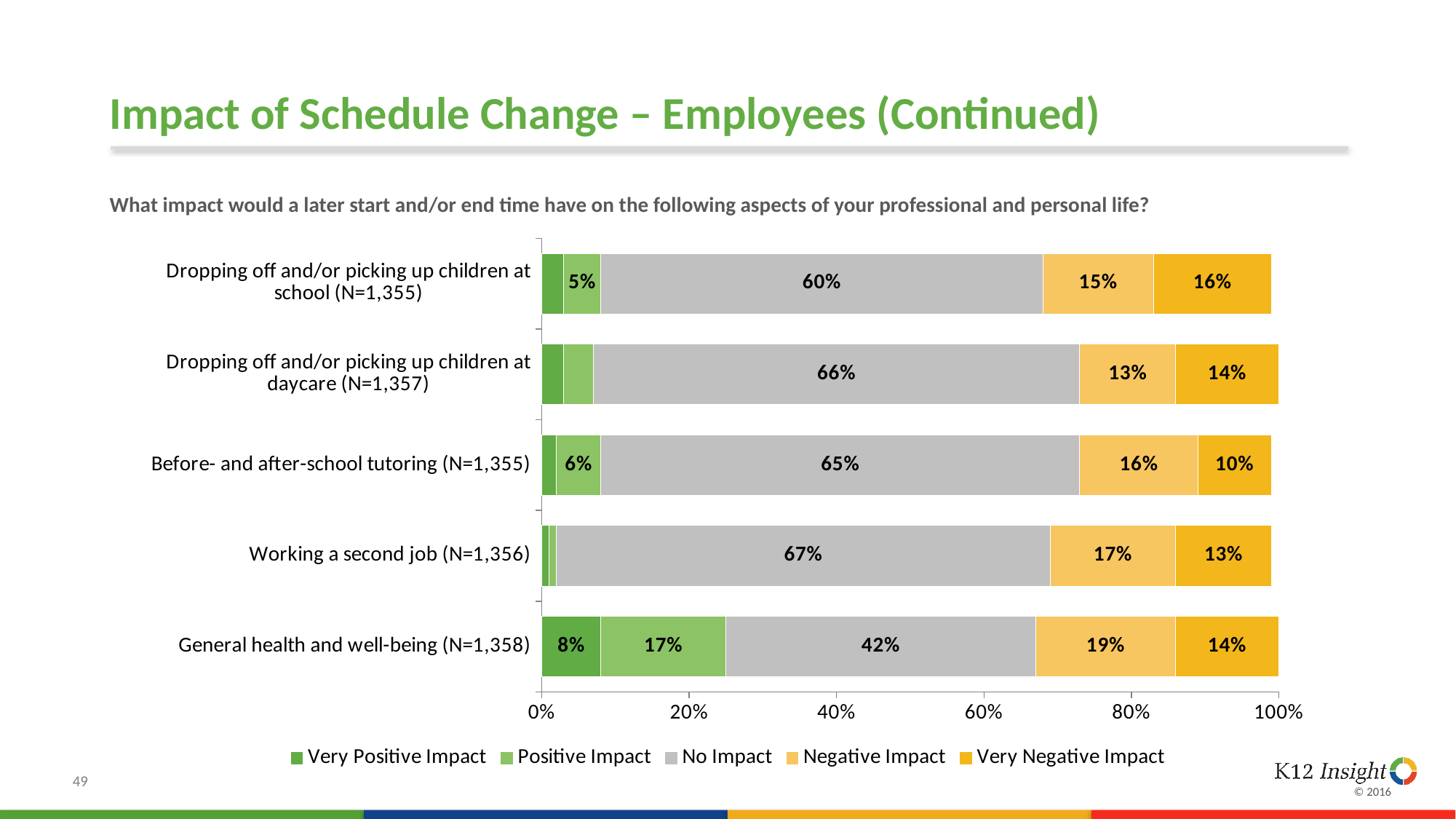
What is the total of all segments in the General health and well-being (N=1,358) bar? 100% How many series does the legend list? 5 How many categories (aspects of life) are plotted in the chart? 5 Which has the larger Negative Impact value: Working a second job (N=1,356) or Dropping off and/or picking up children at daycare (N=1,357)? Working a second job (N=1,356) What is the Very Positive Impact value for General health and well-being (N=1,358)? 8% Which category has the highest No Impact value? Working a second job (N=1,356) Which legend entry is shown in grey? No Impact What is the Very Negative Impact value for Before- and after-school tutoring (N=1,355)? 10% What is the No Impact value for Working a second job (N=1,356)? 67% What kind of chart is shown on the slide? Stacked bar chart What is the difference between the No Impact value for Dropping off and/or picking up children at school (N=1,355) and for General health and well-being (N=1,358)? 18 percentage points Which category has the lowest No Impact value? General health and well-being (N=1,358)